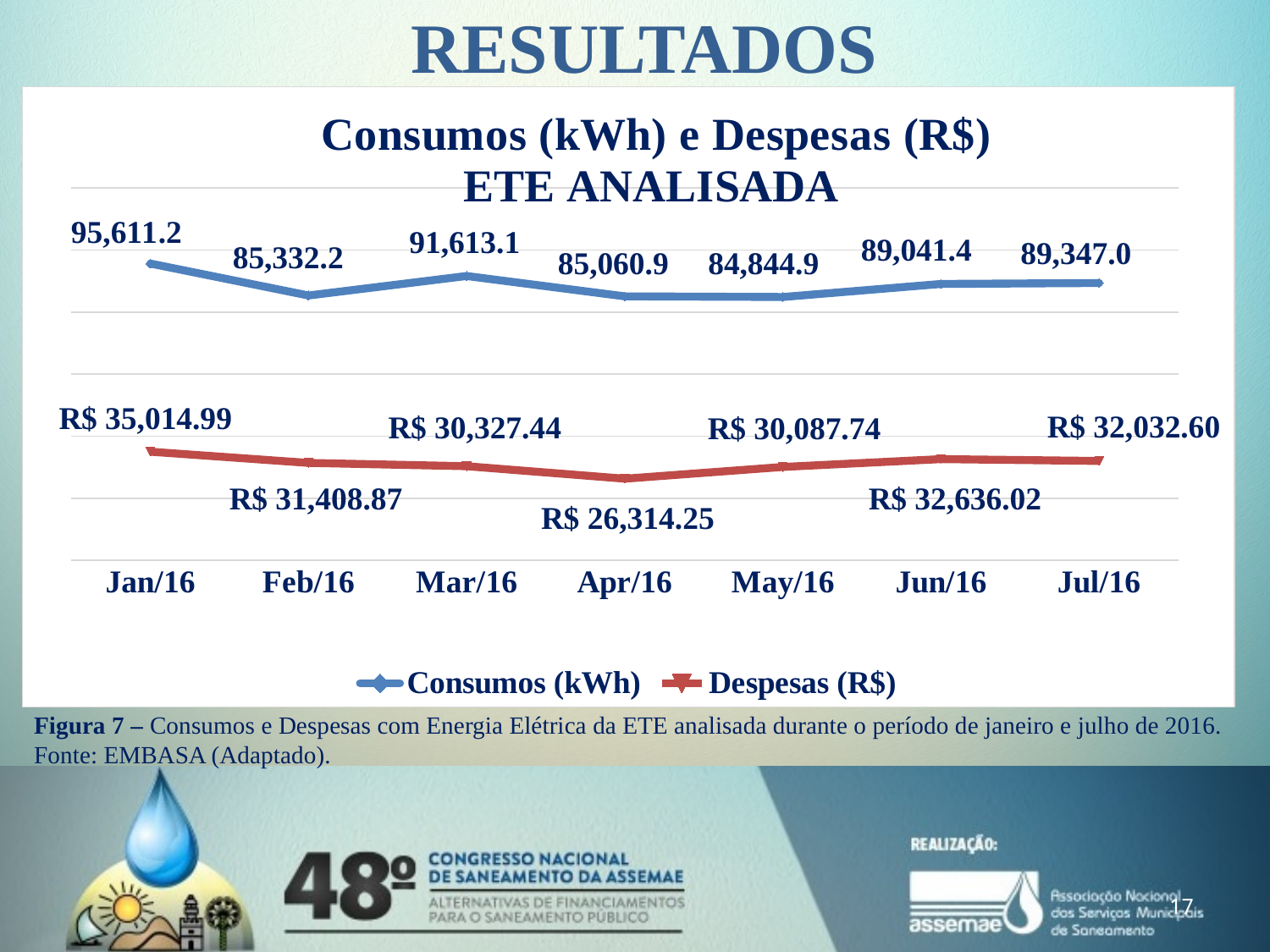
In which month is Consumos (kWh) highest? Jan/16 What is the difference in Consumos (kWh) between Jan/16 and Feb/16? 10,279.0 What kind of chart is shown on the slide? Line chart What is the value of Consumos (kWh) for Mar/16? 91,613.1 In which month is Despesas (R$) lowest? Apr/16 What is the difference in Despesas (R$) between Jan/16 and Apr/16? R$ 8,700.74 What is the value of Despesas (R$) for Apr/16? R$ 26,314.25 In which month is Consumos (kWh) lowest? May/16 How many series does the legend list? 2 What is the value of Despesas (R$) for Jun/16? R$ 32,636.02 Which month has the larger Despesas (R$), Jun/16 or Jul/16? Jun/16 How many months are shown on the x axis? 7